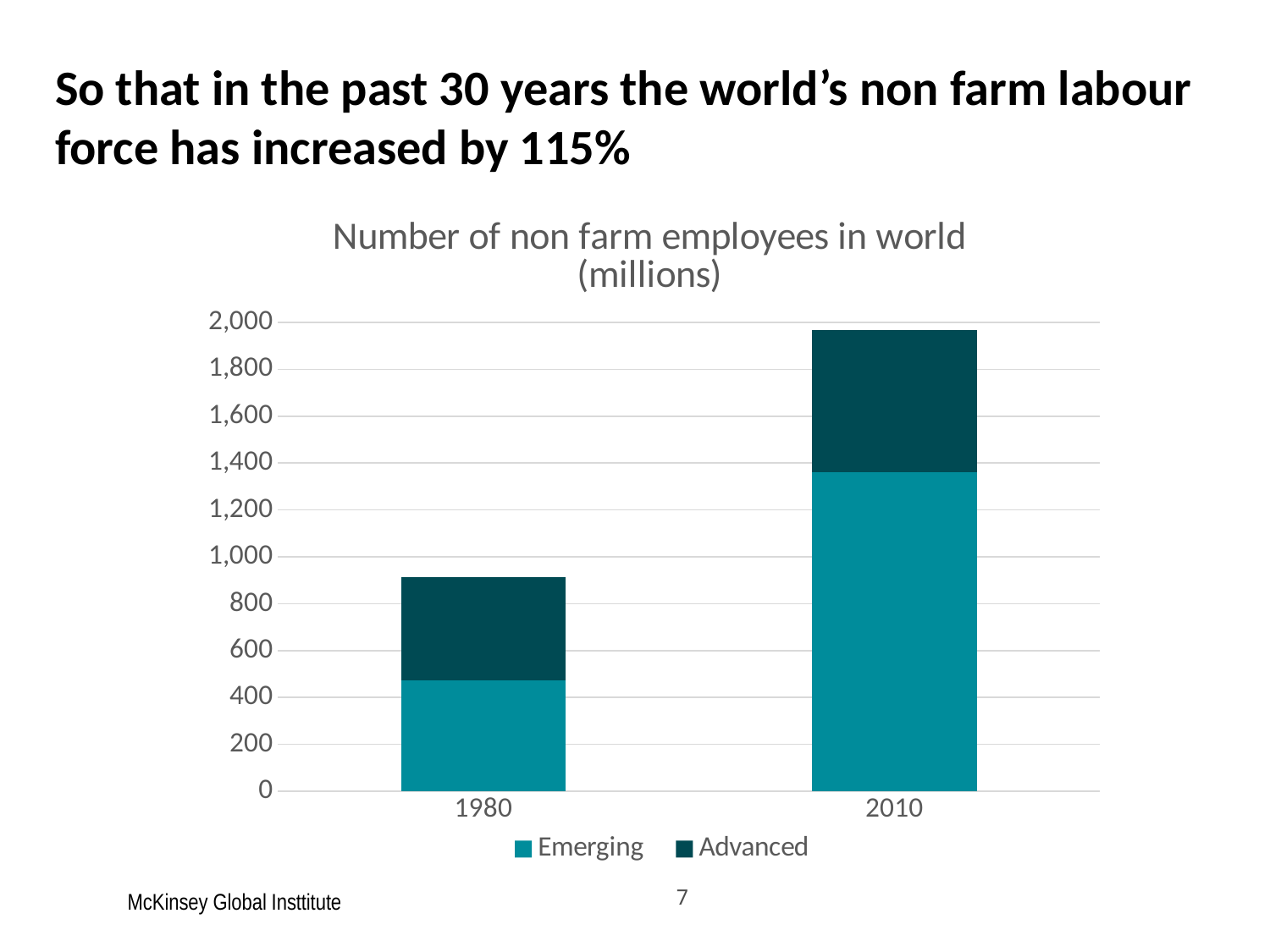
Is the total bar for 2010 greater or less than 1,800? greater Which year has the taller total bar, 1980 or 2010? 2010 How many series does the legend list? 2 In 2010, which segment is larger, Emerging or Advanced? Emerging Which two series are listed in the legend? Emerging and Advanced Does the total number of non farm employees rise or fall from 1980 to 2010? rise What is the title of the chart? Number of non farm employees in world (millions) How many years (categories) are shown on the x axis? 2 Is the Emerging segment for 2010 greater or less than 1,200? greater Is the total bar for 1980 greater or less than 1,000? less What kind of chart is shown on the slide? Stacked bar chart